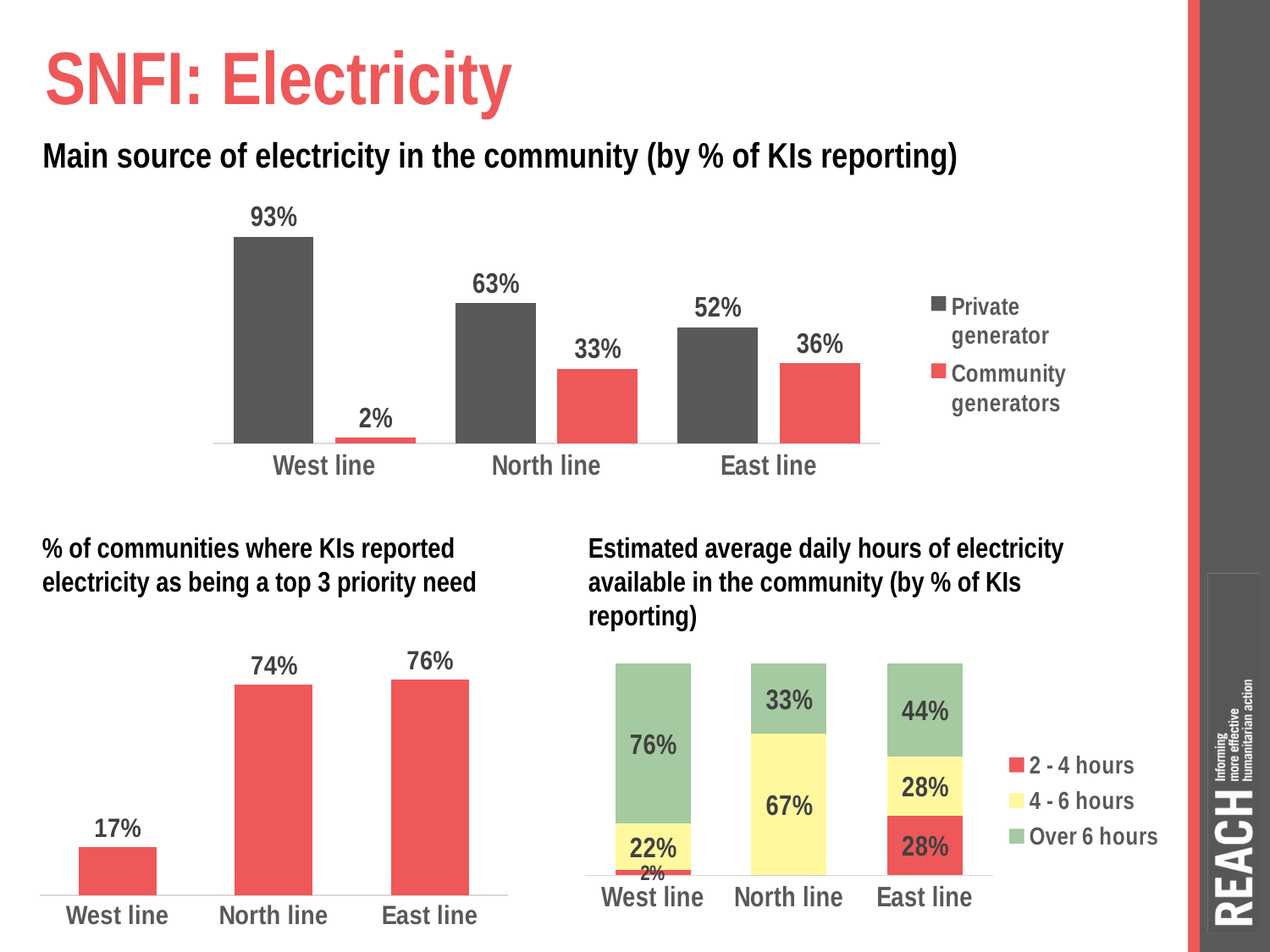
In the 'Main source of electricity in the community' chart, which line has the lowest value for community generators? West line In the 'Estimated average daily hours of electricity' chart, which line has the highest value for over 6 hours? West line In the '% of communities where KIs reported electricity as being a top 3 priority need' chart, what is the value for West line? 17% In the 'Main source of electricity in the community' chart, what percentage of KIs in West line reported a private generator? 93% What kind of chart is the '% of communities where KIs reported electricity as being a top 3 priority need' chart? Bar chart In the 'Main source of electricity in the community' chart, what percentage of KIs in East line reported community generators? 36% In the 'Main source of electricity in the community' chart, what is the difference between the private generator and community generators values for North line? 30% In the 'Main source of electricity in the community' chart, how many series does the legend list? 2 In the 'Estimated average daily hours of electricity' chart, what percentage of KIs in East line reported over 6 hours? 44% In the '% of communities where KIs reported electricity as being a top 3 priority need' chart, what is the difference between East line and North line? 2% In the 'Estimated average daily hours of electricity' chart, what percentage of KIs in North line reported 4 - 6 hours? 67% In the '% of communities where KIs reported electricity as being a top 3 priority need' chart, which line has the highest value? East line